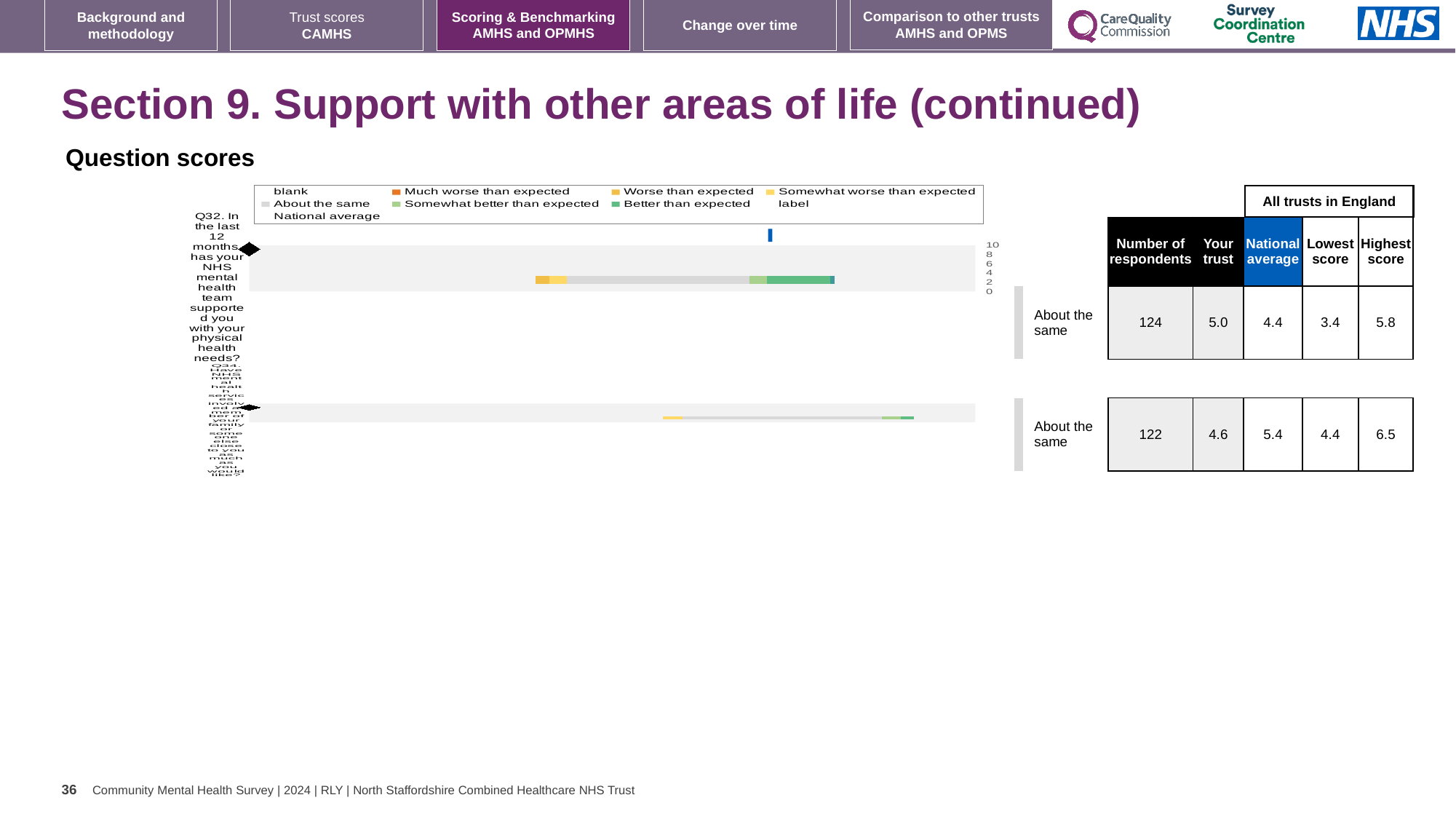
What is the highest score among all trusts in England for Q34? 6.5 What is the number of respondents for Q32? 124 What is the national average score for Q34? 5.4 What is the lowest score among all trusts in England for Q32? 3.4 What is the 'Your trust' score for Q32? 5.0 What is the difference between the highest score and the lowest score for Q32? 2.4 For Q34, which is larger: the 'Your trust' score or the national average? National average What benchmark category is shown for Q34 in the chart? About the same What kind of chart is shown on the slide? bar chart How many entries does the chart legend list? 9 How many questions (categories) are plotted in the chart? 2 For Q32, which is larger: the 'Your trust' score or the national average? Your trust